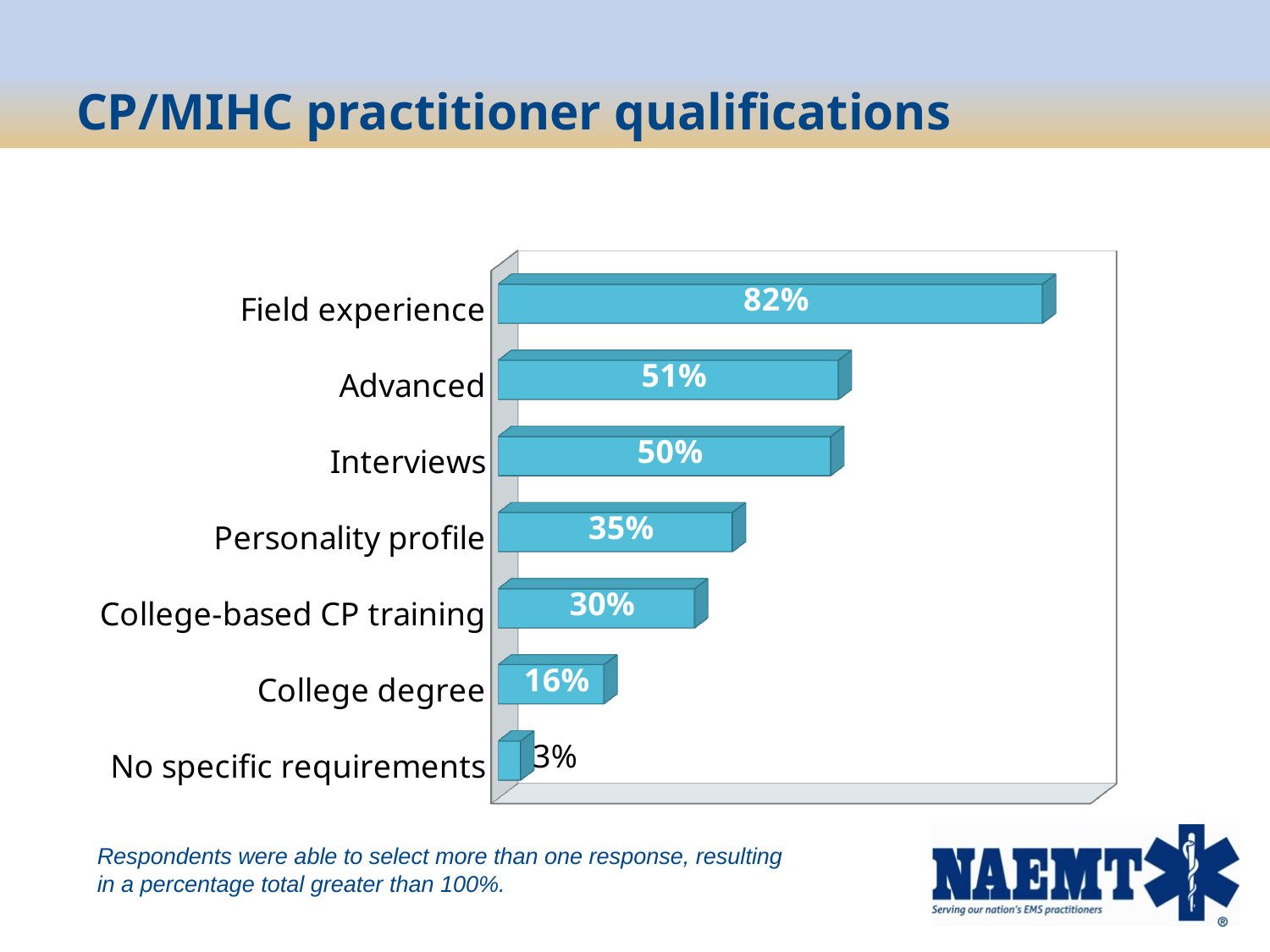
What percentage is shown for No specific requirements? 3% How many categories are shown in the chart? 7 What is the title of the slide containing the chart? CP/MIHC practitioner qualifications Which category has the lowest percentage? No specific requirements Which has a higher percentage, Interviews or Personality profile? Interviews What is the difference between the percentages for College-based CP training and College degree? 14% What percentage is shown for College-based CP training? 30% What percentage is shown for Personality profile? 35% Which qualification has the highest percentage? Field experience What is the difference between the percentages for Field experience and Advanced? 31% What percentage is shown for Field experience? 82% What kind of chart is shown on the slide? Bar chart